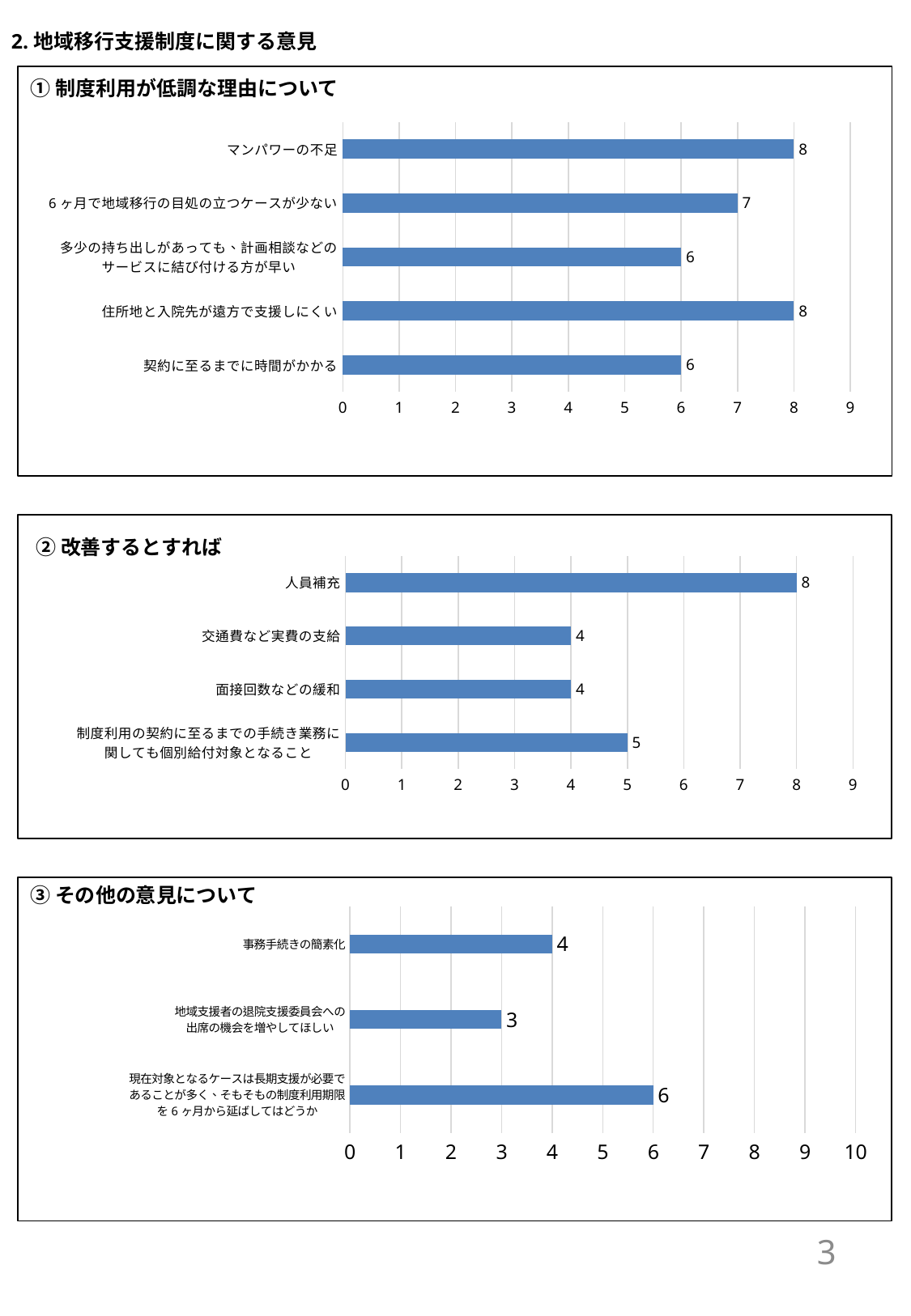
In the chart titled ② 改善するとすれば, how many categories are shown? 4 In the chart titled ① 制度利用が低調な理由について, what is the value for 6ヶ月で地域移行の目処の立つケースが少ない? 7 In the chart titled ① 制度利用が低調な理由について, what is the value for マンパワーの不足? 8 In the chart titled ③ その他の意見について, what is the value for 事務手続きの簡素化? 4 In the chart titled ③ その他の意見について, which category has the lowest value? 地域支援者の退院支援委員会への出席の機会を増やしてほしい What kind of chart is the chart titled ③ その他の意見について? bar chart In the chart titled ② 改善するとすれば, which is larger: the value for 人員補充 or the value for 面接回数などの緩和? 人員補充 In the chart titled ① 制度利用が低調な理由について, how many categories are shown? 5 In the chart titled ③ その他の意見について, what is the difference between the highest and lowest values? 3 In the chart titled ② 改善するとすれば, which category has the highest value? 人員補充 In the chart titled ① 制度利用が低調な理由について, what is the difference between the values for マンパワーの不足 and 契約に至るまでに時間がかかる? 2 In the chart titled ② 改善するとすれば, what is the value for 交通費など実費の支給? 4